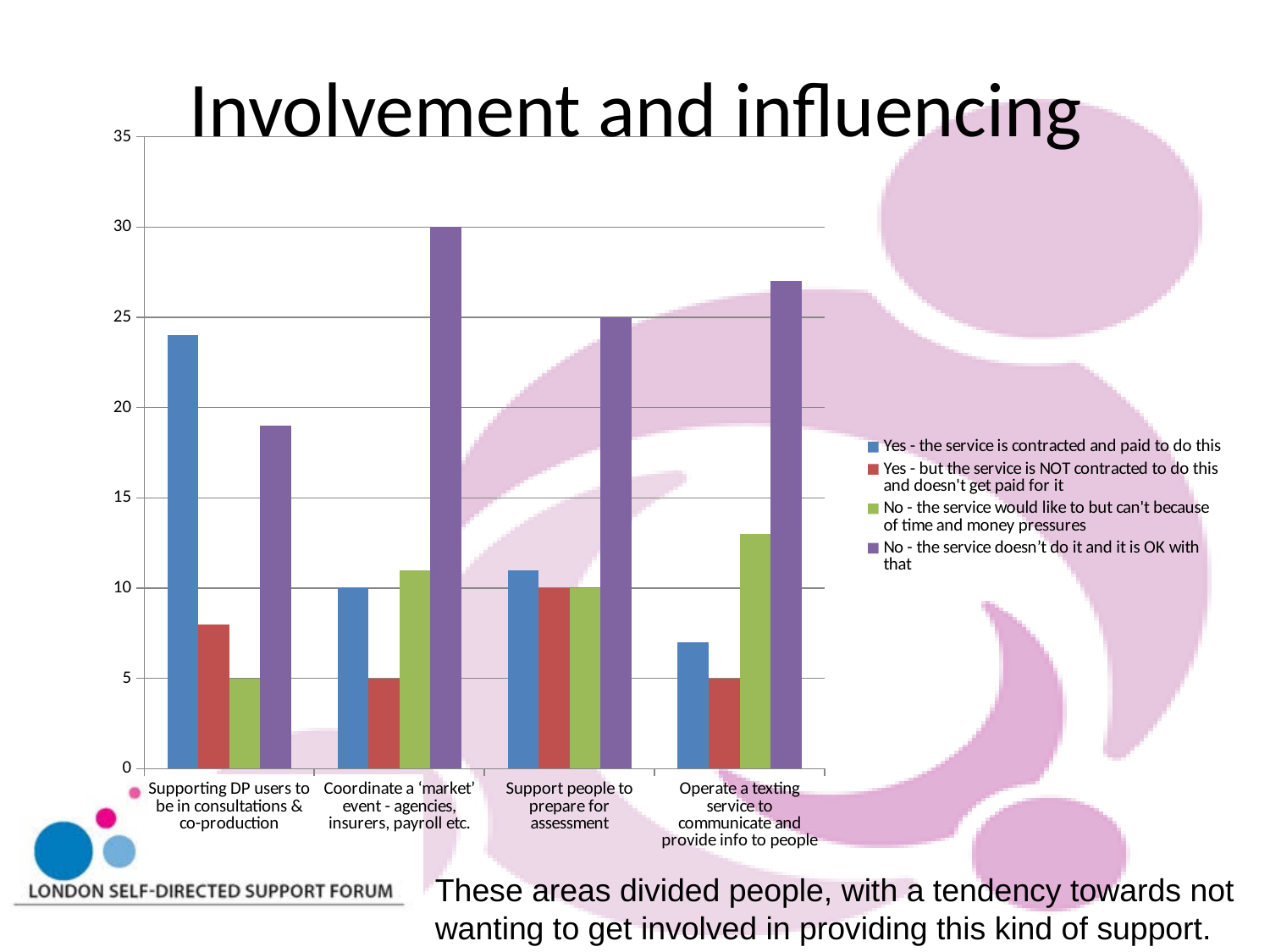
What is the value for 'No - the service doesn't do it and it is OK with that' for 'Coordinate a 'market' event - agencies, insurers, payroll etc.'? 30 How many categories are shown on the x axis? 4 What is the value for 'Yes - the service is contracted and paid to do this' for 'Coordinate a 'market' event - agencies, insurers, payroll etc.'? 10 What is the value for 'No - the service would like to but can't because of time and money pressures' for 'Supporting DP users to be in consultations & co-production'? 5 What is the value for 'No - the service doesn't do it and it is OK with that' for 'Support people to prepare for assessment'? 25 Is the value for 'Yes - the service is contracted and paid to do this' for 'Operate a texting service to communicate and provide info to people' greater or less than 10? less Which category has the highest value for 'No - the service doesn't do it and it is OK with that'? Coordinate a 'market' event - agencies, insurers, payroll etc. Is the value for 'Yes - the service is contracted and paid to do this' for 'Supporting DP users to be in consultations & co-production' greater or less than 20? greater Which category has the highest value for 'Yes - the service is contracted and paid to do this'? Supporting DP users to be in consultations & co-production How many series does the legend list? 4 What kind of chart is shown on the slide? bar chart For 'Supporting DP users to be in consultations & co-production', which is larger: 'Yes - the service is contracted and paid to do this' or 'No - the service doesn't do it and it is OK with that'? Yes - the service is contracted and paid to do this